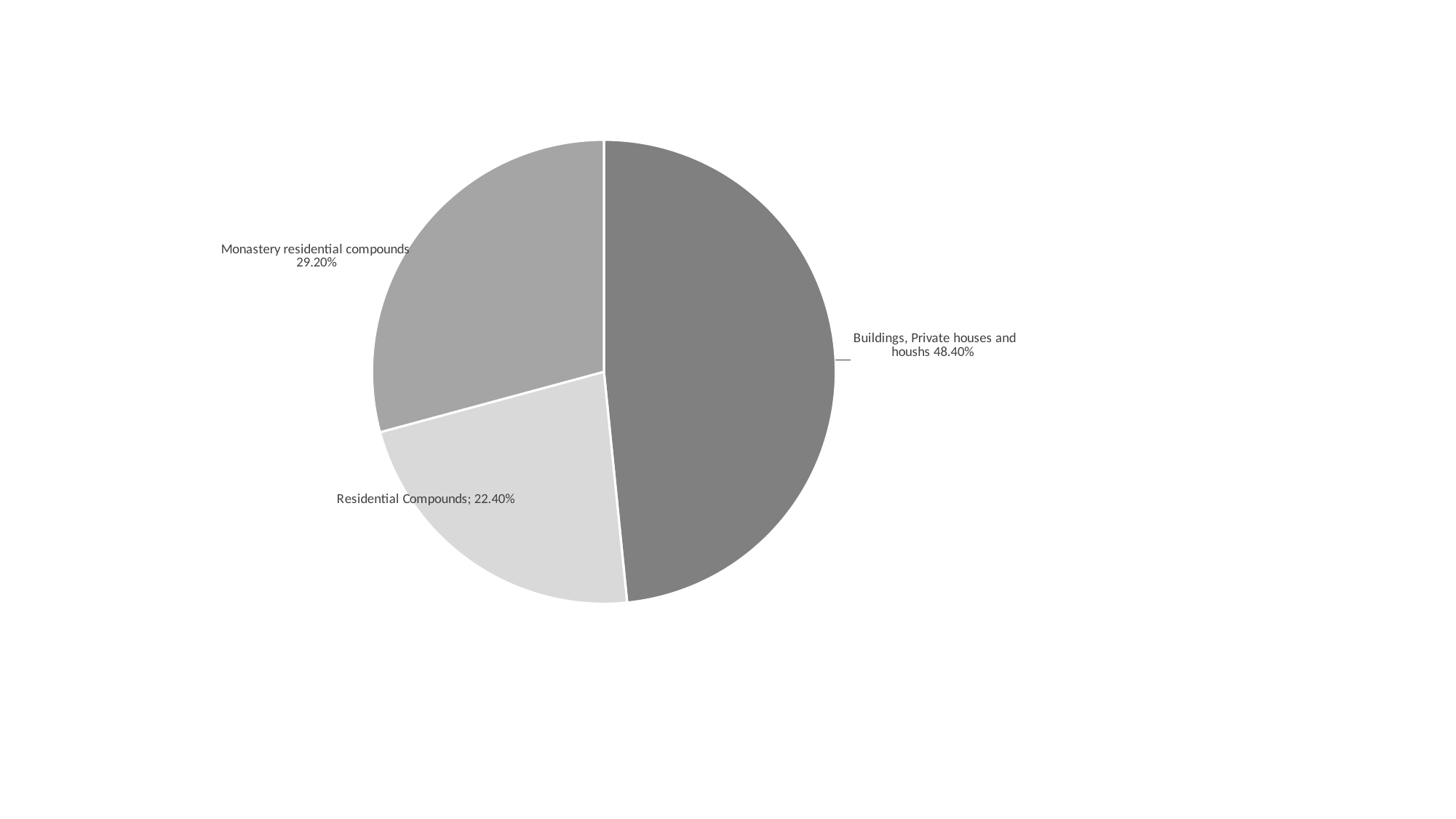
Is the share for Buildings, Private houses and houshs greater or less than 50%? less Which slice of the pie chart is the darkest grey? Buildings, Private houses and houshs How many slices does the pie chart have? 3 What share of the pie is labelled for Monastery residential compounds? 29.20% Which slice of the pie chart is the largest? Buildings, Private houses and houshs Which slice of the pie chart is the smallest? Residential Compounds What share of the pie is labelled for Residential Compounds? 22.40% What is the difference in percentage points between the Buildings, Private houses and houshs slice and the Monastery residential compounds slice? 19.20% Which is larger: the Monastery residential compounds slice or the Residential Compounds slice? Monastery residential compounds What kind of chart is shown on the slide? pie chart What is the difference in percentage points between the Monastery residential compounds slice and the Residential Compounds slice? 6.80% What share of the pie is labelled for Buildings, Private houses and houshs? 48.40%